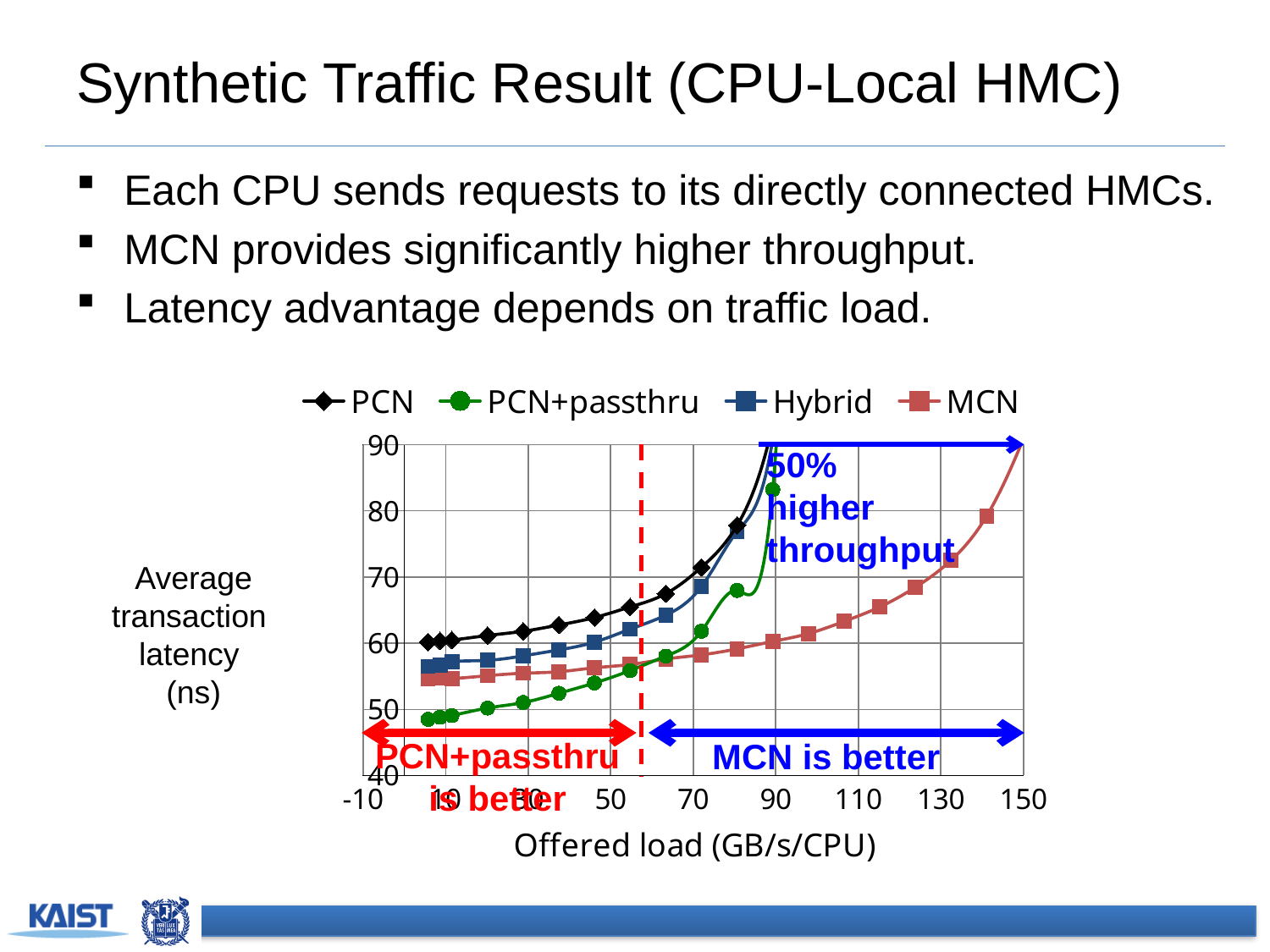
Does the MCN latency rise or fall as offered load increases along the x axis? rise What kind of chart is shown on the slide? line chart At an offered load of about 10 GB/s/CPU, which series has the lower latency, PCN or PCN+passthru? PCN+passthru What is the label of the chart's x axis? Offered load (GB/s/CPU) Does the PCN latency rise or fall as offered load increases along the x axis? rise At an offered load of about 50 GB/s/CPU, is the Hybrid latency greater or less than 70 ns? less What are the series names listed in the chart's legend? PCN, PCN+passthru, Hybrid, MCN At an offered load of about 90 GB/s/CPU, which series has the lower latency, MCN or PCN+passthru? MCN How many series does the chart's legend list? 4 Which series extends to the highest offered load on the chart? MCN At an offered load of about 140 GB/s/CPU, is the MCN latency greater or less than 70 ns? greater At an offered load of about 10 GB/s/CPU, is the PCN latency greater or less than 50 ns? greater